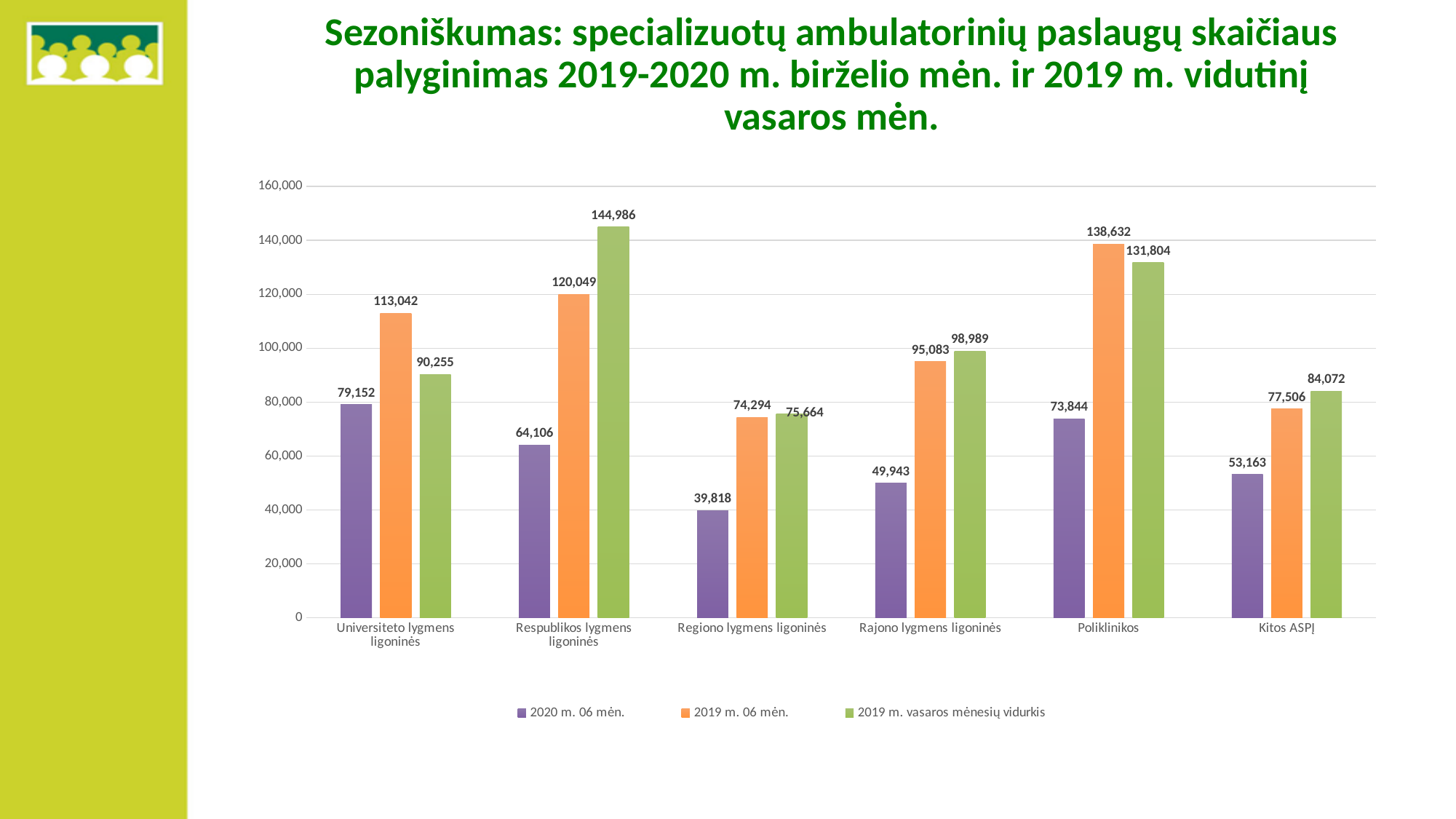
For Poliklinikos, which is larger: the 2019 m. 06 mėn. value or the 2019 m. vasaros mėnesių vidurkis value? 2019 m. 06 mėn. How many series does the legend list? 3 What is the value for Respublikos lygmens ligoninės in the 2019 m. vasaros mėnesių vidurkis series? 144,986 What is the value for Kitos ASPĮ in the 2019 m. 06 mėn. series? 77,506 What kind of chart is shown on the slide? Bar chart How many categories are shown on the x axis? 6 Which category has the highest value in the 2020 m. 06 mėn. series? Universiteto lygmens ligoninės Which category has the lowest value in the 2020 m. 06 mėn. series? Regiono lygmens ligoninės What is the difference between the 2019 m. vasaros mėnesių vidurkis and 2019 m. 06 mėn. values for Respublikos lygmens ligoninės? 24,937 What is the difference between the 2019 m. 06 mėn. and 2020 m. 06 mėn. values for Poliklinikos? 64,788 Which category has the highest value in the 2019 m. 06 mėn. series? Poliklinikos What is the value for Poliklinikos in the 2020 m. 06 mėn. series? 73,844